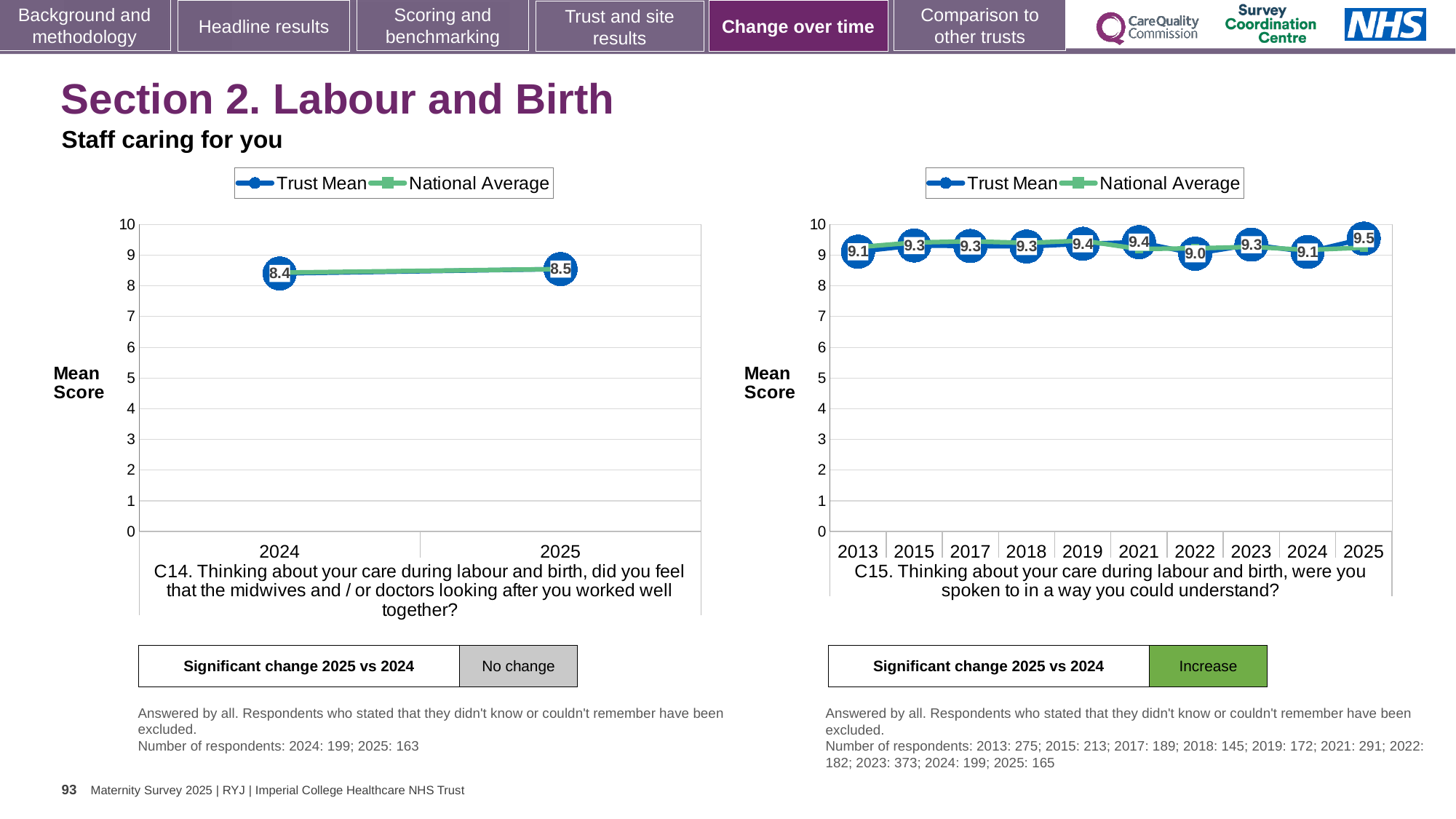
In the right chart (C15), what is the Trust Mean score for 2025? 9.5 In the left chart (C14), what is the Trust Mean score for 2025? 8.5 In the right chart (C15), how many years are plotted on the x axis? 10 What kind of chart is the left chart (C14)? Line chart In the right chart (C15), which year has the highest Trust Mean score? 2025 How many series does the legend of the right chart (C15) list? 2 In the left chart (C14), how many years are plotted on the x axis? 2 In the left chart (C14), what is the Trust Mean score for 2024? 8.4 In the right chart (C15), what is the difference between the Trust Mean scores for 2025 and 2022? 0.5 In the right chart (C15), which year has the lowest Trust Mean score? 2022 In the left chart (C14), what is the difference between the Trust Mean scores for 2025 and 2024? 0.1 In the right chart (C15), what is the Trust Mean score for 2022? 9.0